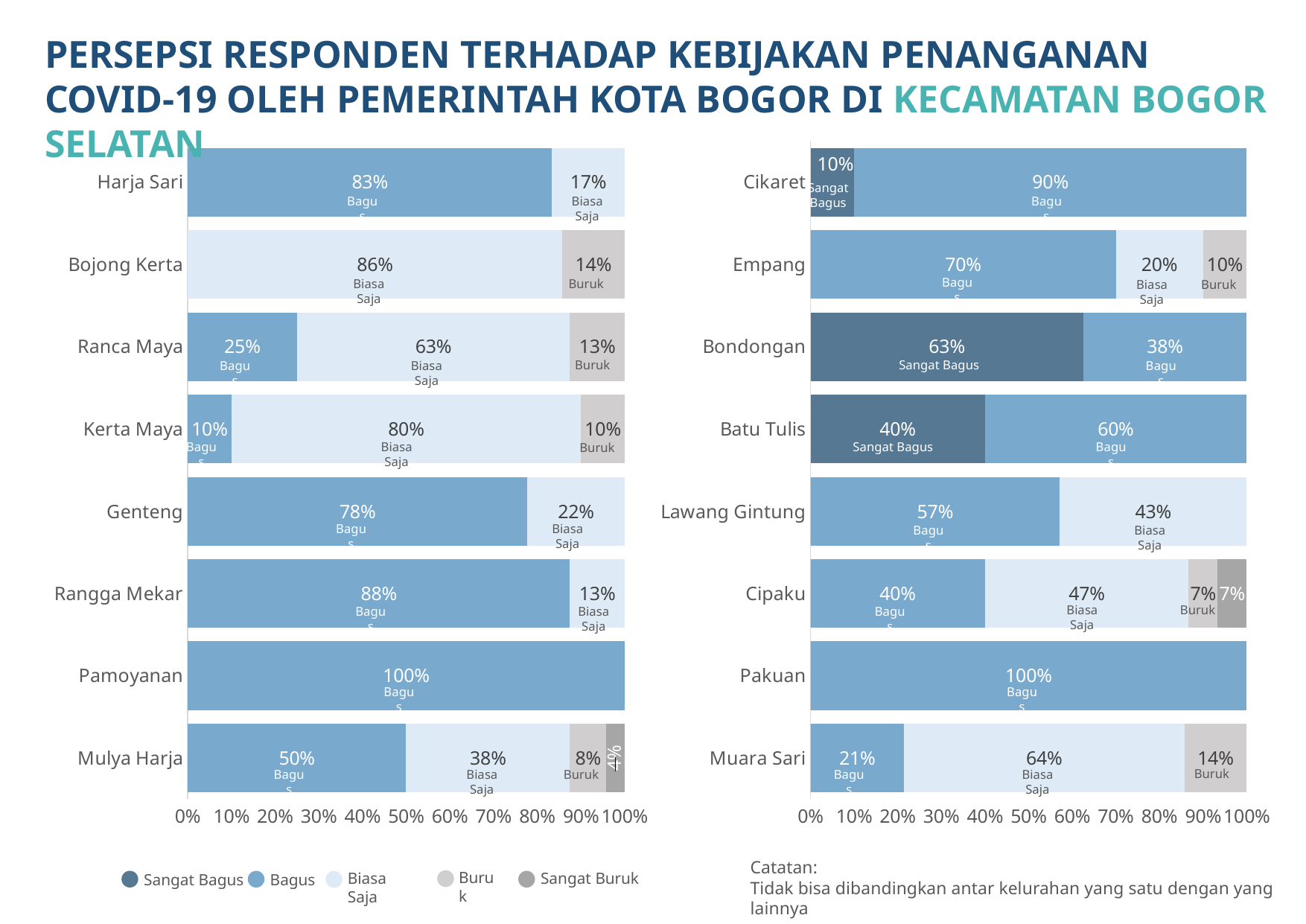
How many categories does the legend list? 5 On the right chart, which kelurahan has the highest 'Sangat Bagus' share? Bondongan On the right chart, what is the total of the 'Bagus' and 'Biasa Saja' shares for Lawang Gintung? 100% On the left chart, what percentage of respondents in Harja Sari rated the policy 'Bagus'? 83% On the right chart, what percentage of respondents in Muara Sari rated the policy 'Buruk'? 14% On the left chart, what percentage of respondents in Kerta Maya rated the policy 'Biasa Saja'? 80% On the left chart, which is larger: the 'Biasa Saja' share in Ranca Maya or the 'Biasa Saja' share in Mulya Harja? Ranca Maya On the right chart, what percentage of respondents in Bondongan rated the policy 'Sangat Bagus'? 63% How many kelurahan are shown on the left chart? 8 On the left chart, which kelurahan has the highest 'Bagus' share? Pamoyanan On the right chart, what is the difference between the 'Bagus' share in Cikaret and the 'Bagus' share in Empang? 20% What type of chart is used on the slide? Stacked bar chart